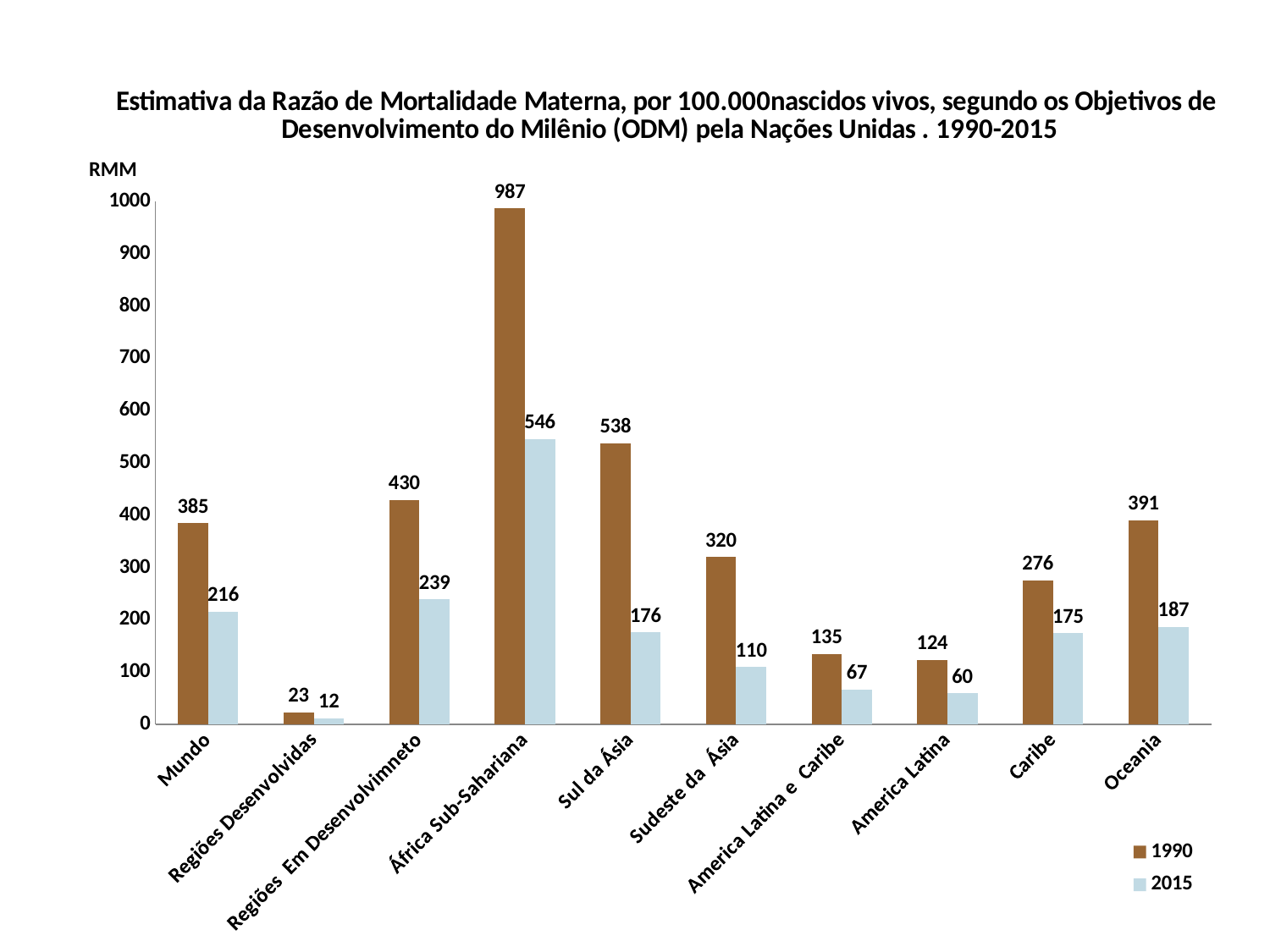
How many series does the legend list? 2 What is the 2015 value for Sul da Ásia? 176 Which category has the lowest 2015 value? Regiões Desenvolvidas What is the 1990 value for África Sub-Sahariana? 987 Which is larger: the 1990 value for Oceania or the 1990 value for Mundo? Oceania Is the 1990 value for Sudeste da Ásia greater or less than 300? greater Which category has the highest 1990 value? África Sub-Sahariana What kind of chart is shown on the slide? bar chart What is the 2015 value for Mundo? 216 How many categories are shown on the x axis? 10 What is the difference between the 1990 and 2015 values for África Sub-Sahariana? 441 What label is shown on the vertical axis? RMM